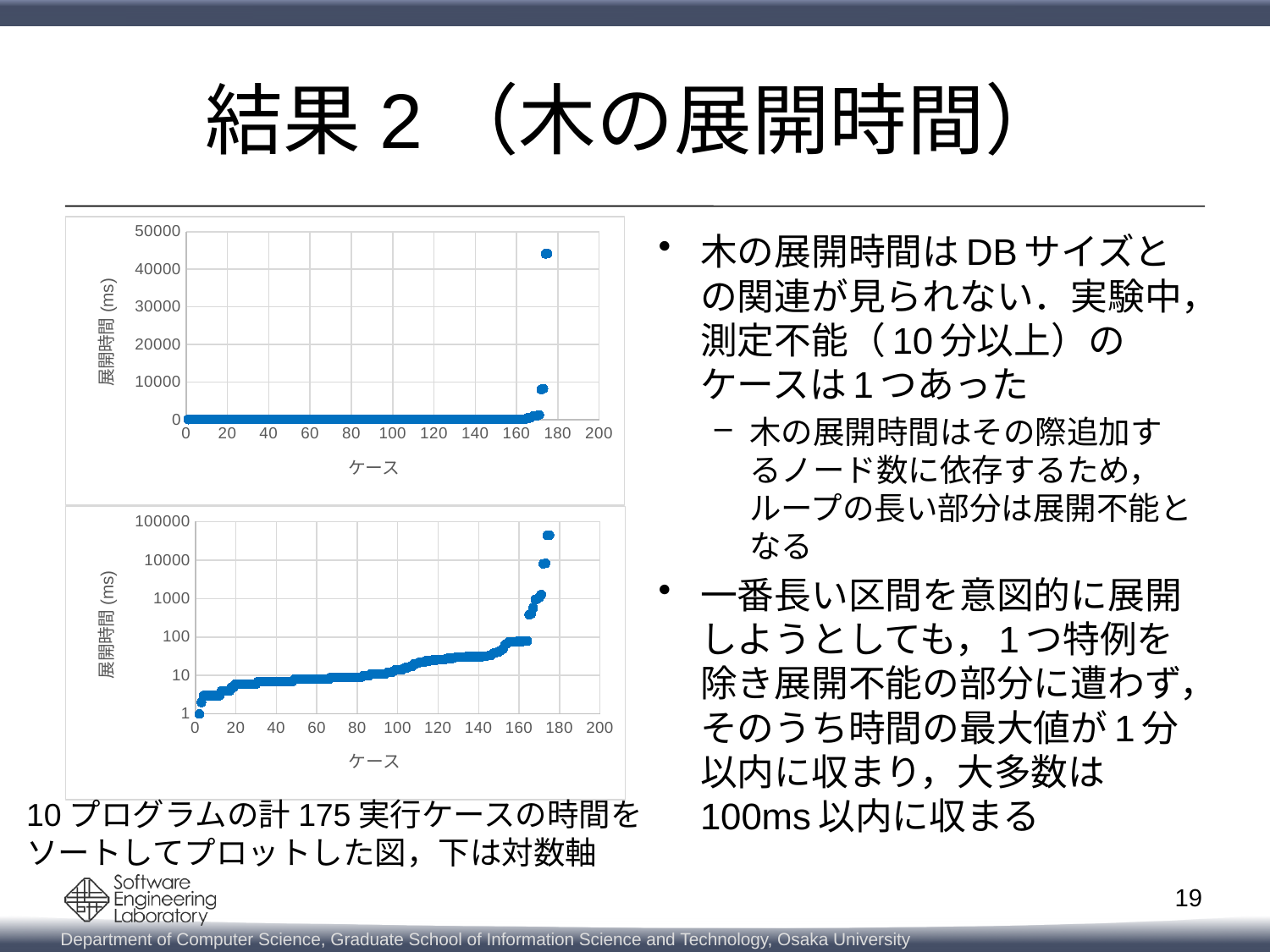
How many charts are shown on the slide? 2 In the top chart, what is the label of the vertical axis? 展開時間 (ms) What kind of chart is the top chart on the slide? scatter chart In the bottom chart, what is the label of the horizontal axis? ケース In the bottom chart, is the value at case 100 greater or less than 100? less In the top chart, do the plotted values rise or fall as the case number increases along the x axis? rise In the top chart, is the highest plotted value greater or less than 40000? greater In the bottom chart, do the plotted values rise or fall along the x axis? rise In the bottom chart, is the highest plotted value greater or less than 10000? greater What kind of chart is the bottom chart on the slide? scatter chart